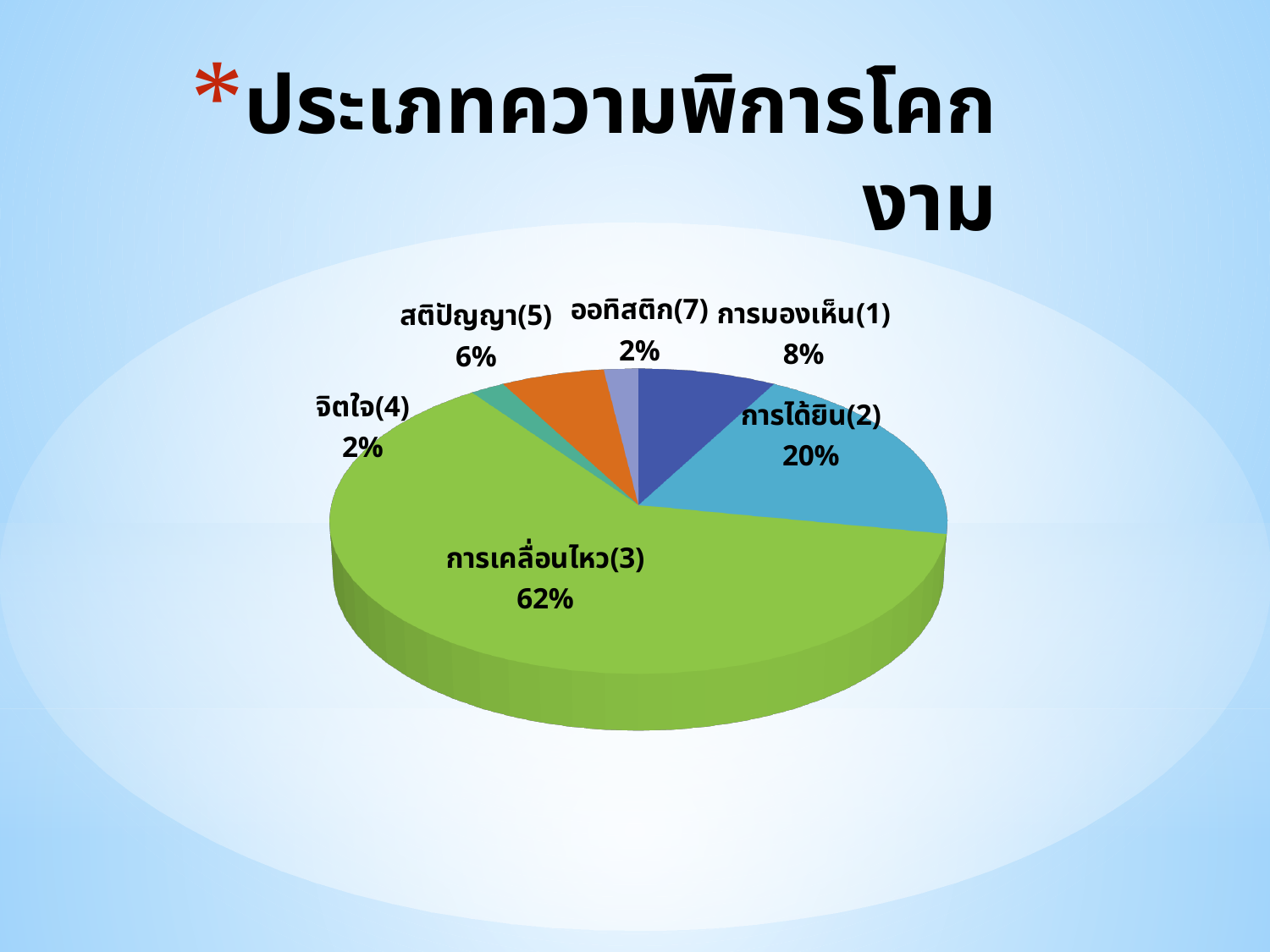
What percentage does the การมองเห็น(1) slice show? 8% What is the combined percentage of จิตใจ(4) and ออทิสติก(7)? 4% What is the title of the slide containing the pie chart? ประเภทความพิการโคกงาม What percentage does the การได้ยิน(2) slice show? 20% What is the difference in percentage points between การเคลื่อนไหว(3) and การได้ยิน(2)? 42 What percentage does the การเคลื่อนไหว(3) slice show? 62% What percentage does the สติปัญญา(5) slice show? 6% How many slices does the pie chart have? 6 What kind of chart is shown on the slide? pie chart Which category has the largest share of the pie? การเคลื่อนไหว(3) What percentage does the ออทิสติก(7) slice show? 2% Which is larger, the share for การมองเห็น(1) or the share for สติปัญญา(5)? การมองเห็น(1)